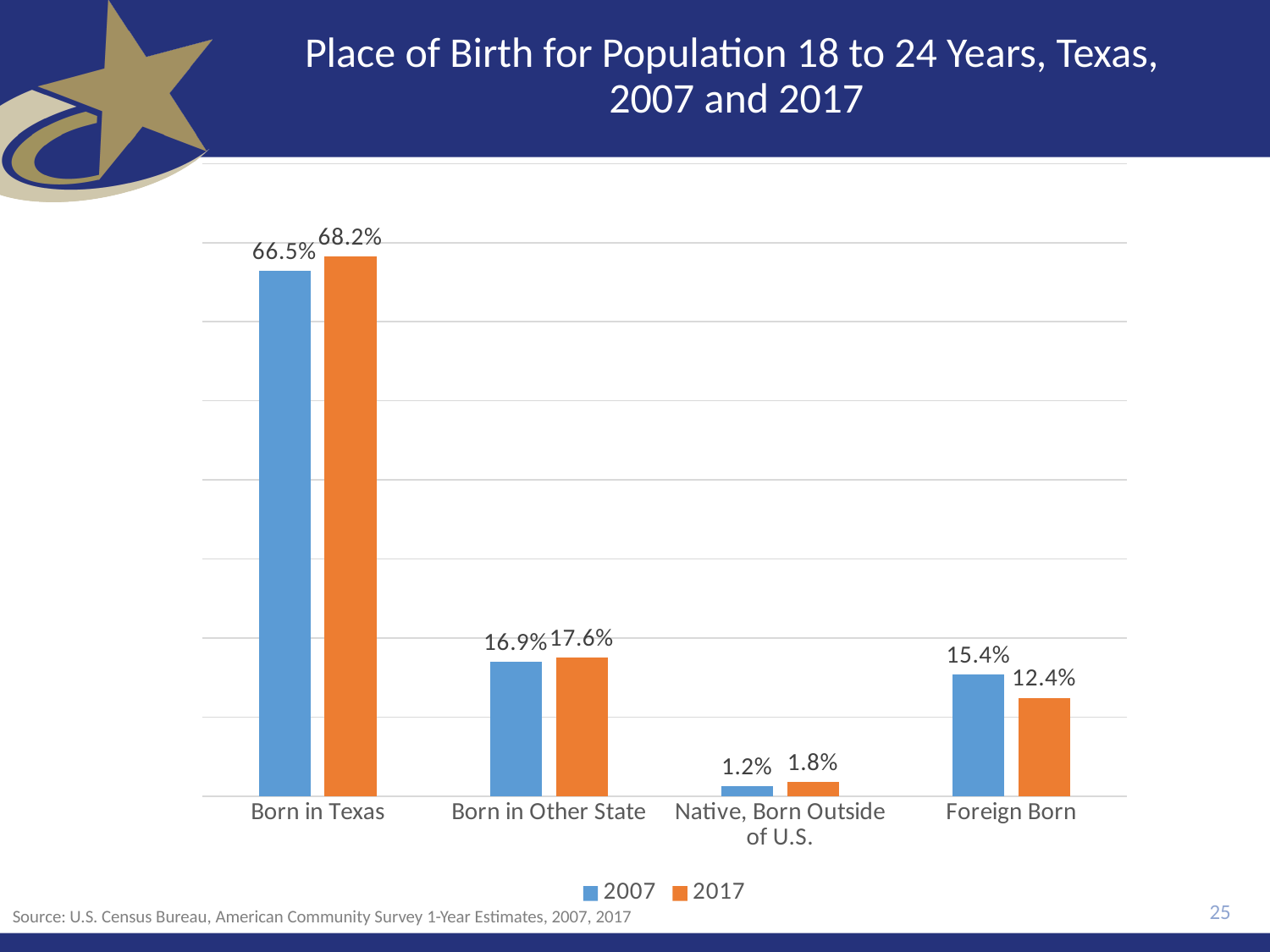
Which category has the lowest 2007 value? Native, Born Outside of U.S. Which is larger for Born in Other State, the 2007 value or the 2017 value? 2017 How many series does the legend list? 2 What is the 2007 value for Born in Texas? 66.5% What is the 2017 value for Native, Born Outside of U.S.? 1.8% Which category has the highest 2017 value? Born in Texas What is the difference between the 2017 and 2007 values for Born in Texas? 1.7% What kind of chart is shown on the slide? Bar chart Which colour represents the 2017 series? Orange How many categories are shown on the x axis? 4 What is the 2017 value for Foreign Born? 12.4% What is the difference between the 2007 and 2017 values for Foreign Born? 3.0%